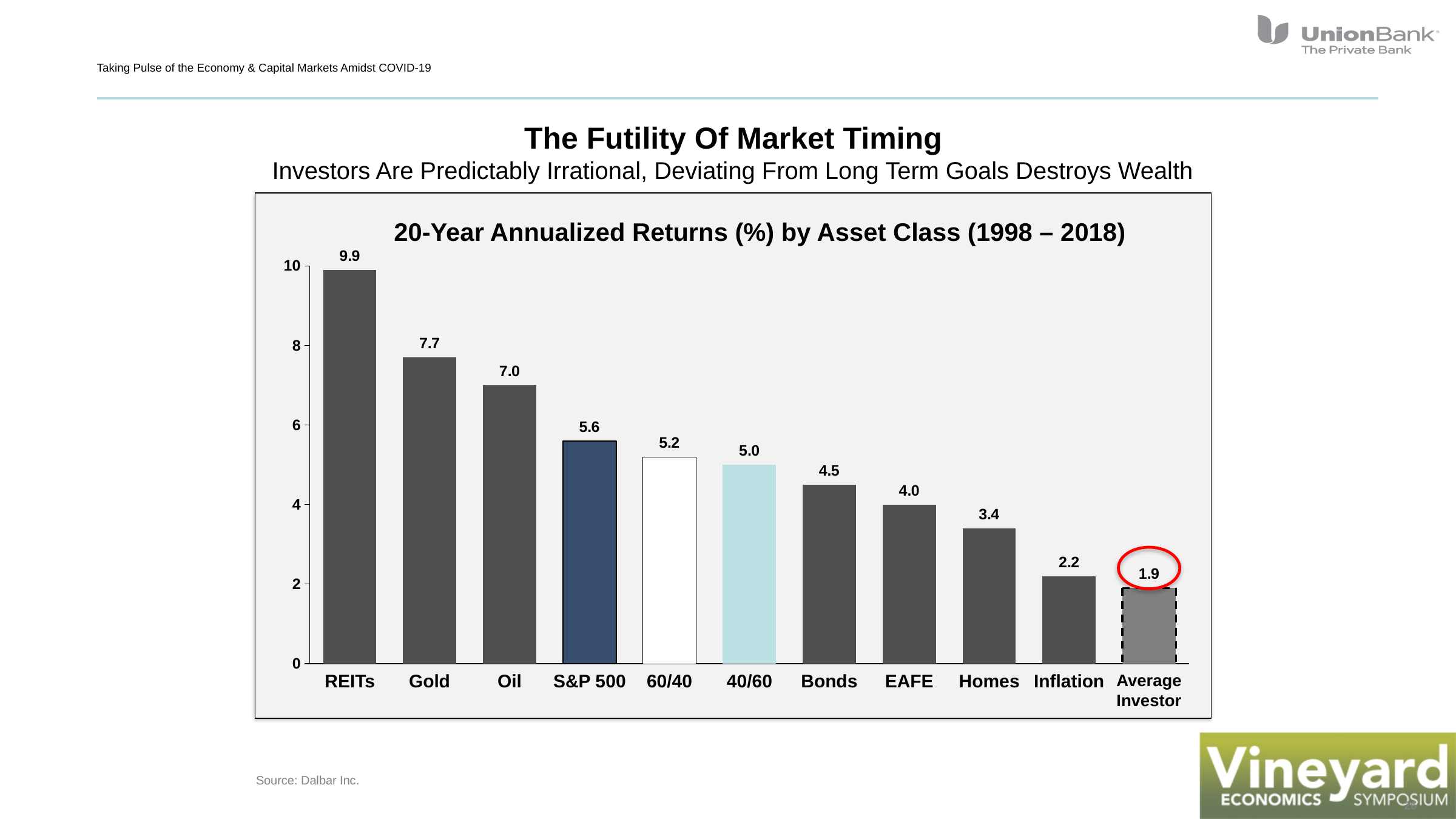
What kind of chart is shown on the slide? Bar chart What is the difference between the S&P 500 return and the Average Investor return? 3.7 Do the values rise or fall moving from left to right along the x axis? Fall What is the title of the chart? 20-Year Annualized Returns (%) by Asset Class (1998 – 2018) What is the difference between the Gold and Oil values? 0.7 Which category has the lowest value on the chart? Average Investor What is the value shown for the S&P 500? 5.6 How many asset classes are shown on the chart? 11 What is the 20-year annualized return for the Average Investor? 1.9 What is the 20-year annualized return for REITs? 9.9 Which is larger, the value for Bonds or the value for EAFE? Bonds Which asset class has the highest 20-year annualized return? REITs